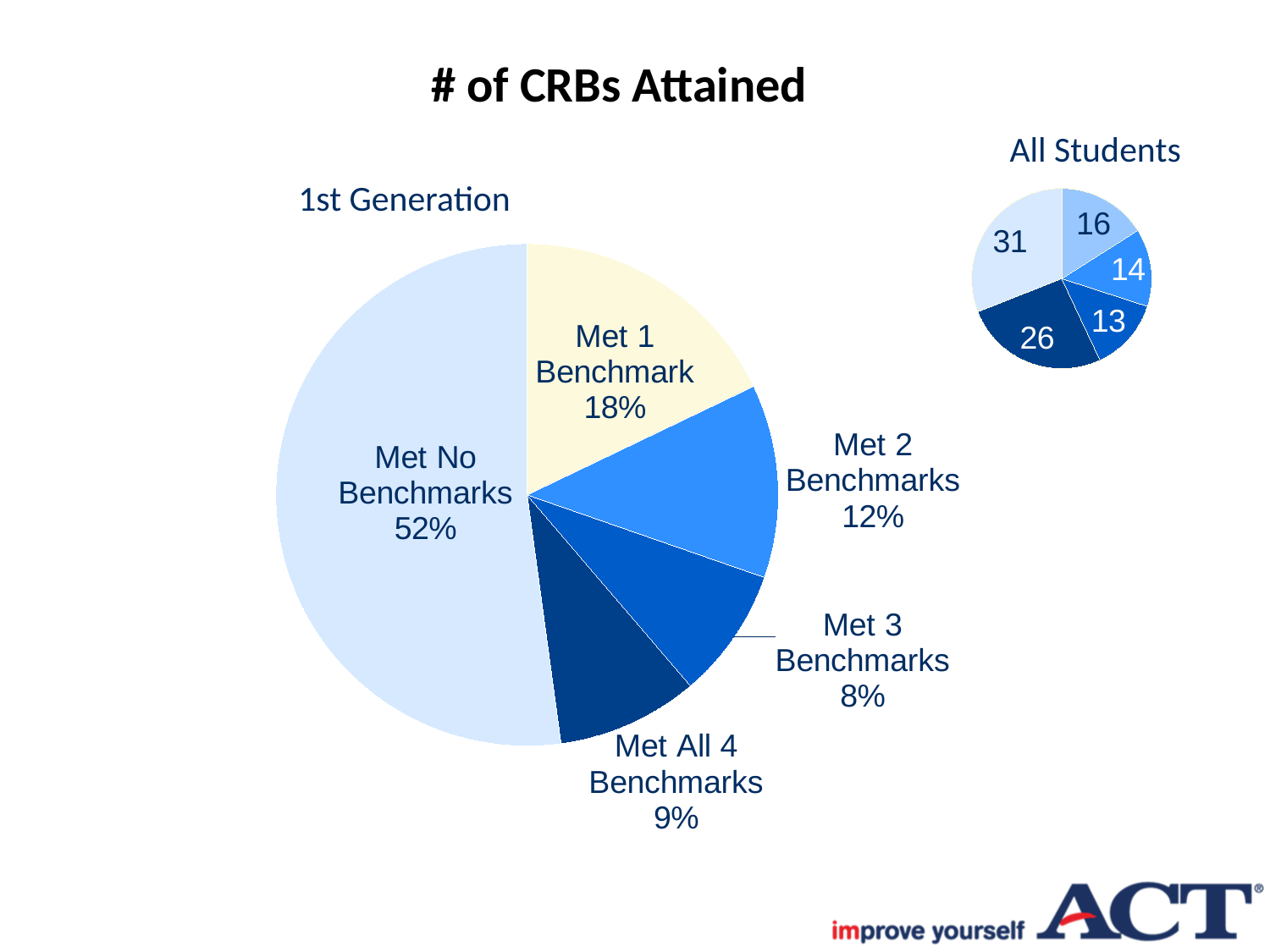
In the 1st Generation pie chart, what is the difference between the Met 1 Benchmark share and the Met 2 Benchmarks share? 6 percentage points What kind of chart is the 1st Generation chart? Pie chart In the 1st Generation pie chart, which is larger: Met All 4 Benchmarks or Met 3 Benchmarks? Met All 4 Benchmarks In the All Students pie chart, what is the largest value shown? 31 How many slices does the 1st Generation pie chart have? 5 What is the title at the top of the slide? # of CRBs Attained In the All Students pie chart, what is the smallest value shown? 13 In the 1st Generation pie chart, which category has the smallest slice? Met 3 Benchmarks In the 1st Generation pie chart, what percentage is shown for Met 1 Benchmark? 18% In the 1st Generation pie chart, what percentage is shown for Met 3 Benchmarks? 8% In the 1st Generation pie chart, which category has the largest slice? Met No Benchmarks In the 1st Generation pie chart, what share of students met no benchmarks? 52%